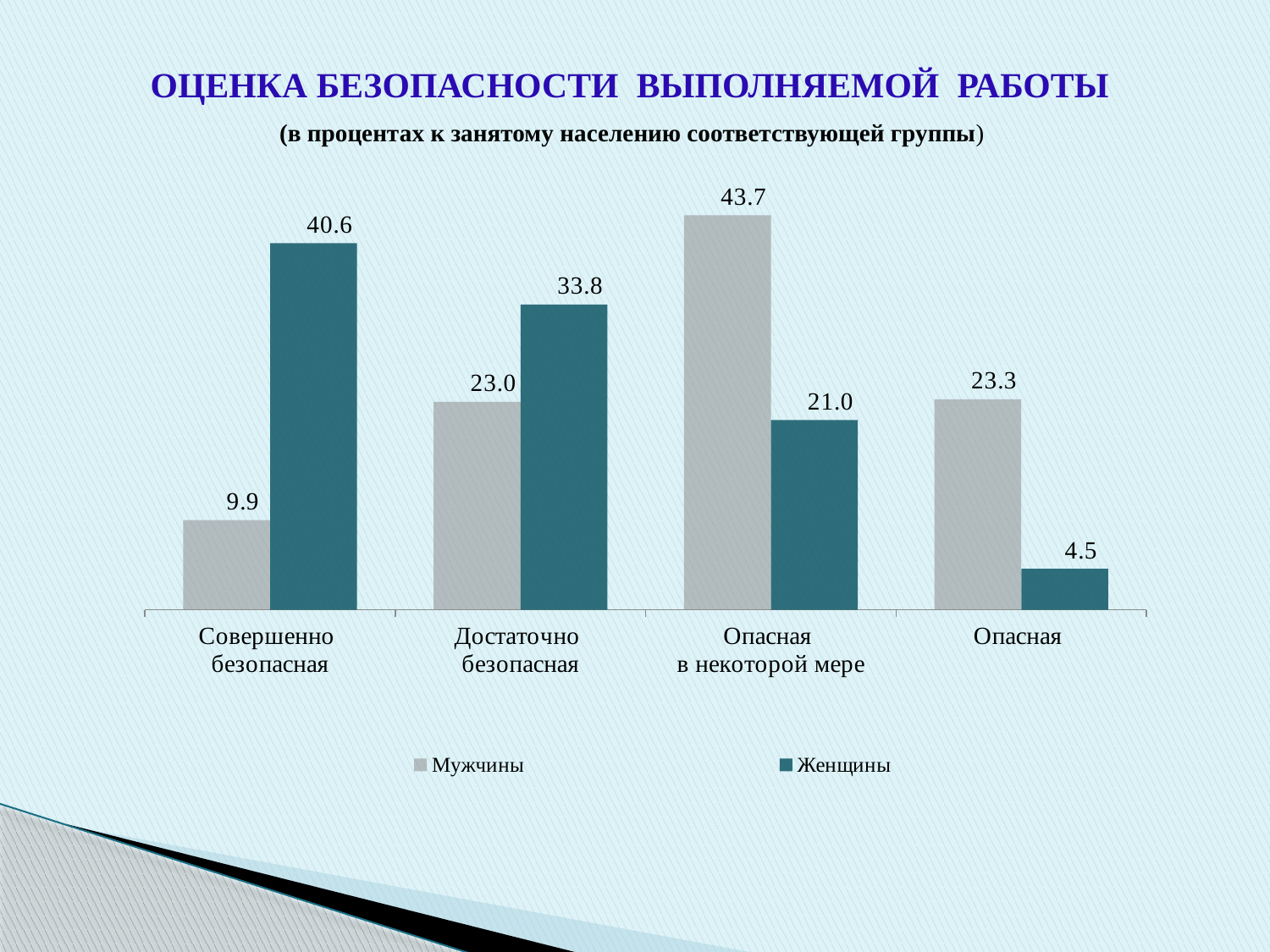
What value is shown for Женщины in the Опасная category? 4.5 Which category has the highest value for Мужчины? Опасная в некоторой мере What kind of chart is shown on the slide? Bar chart How many series does the legend list? 2 How many categories are shown on the x axis? 4 What is the difference between the Женщины and Мужчины values in the Совершенно безопасная category? 30.7 Which series is shown in grey in the legend? Мужчины In the Опасная в некоторой мере category, which series has the larger value, Мужчины or Женщины? Мужчины What is the difference between the Мужчины values for Опасная в некоторой мере and Опасная? 20.4 What value is shown for Мужчины in the Совершенно безопасная category? 9.9 What value is shown for Женщины in the Достаточно безопасная category? 33.8 Which category has the lowest value for Женщины? Опасная